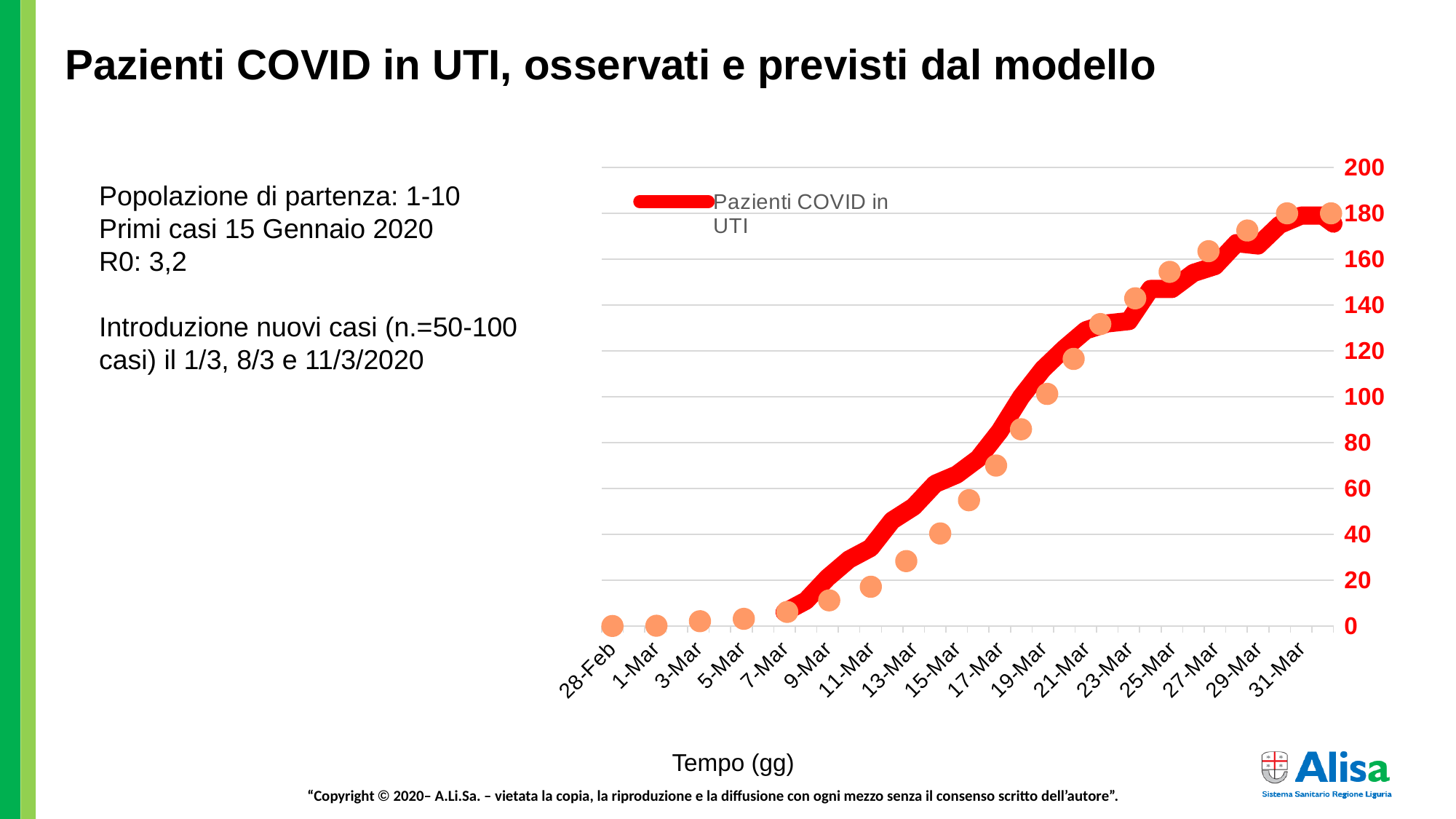
Is the value of the orange dot on 9-Mar greater or less than 40? less Is the value of the red line on 7-Mar greater or less than 20? less How many series does the chart legend list? 1 Is the value of the orange dot on 15-Mar greater or less than 80? less How many date labels are shown on the x axis of the chart? 17 Do the values in the chart rise or fall from 28-Feb to 31-Mar? rise What is the highest value shown on the y axis of the chart? 200 What is the label of the x axis of the chart? Tempo (gg) What kind of chart is shown on the slide? line chart What is the name of the series shown in the chart legend? Pazienti COVID in UTI